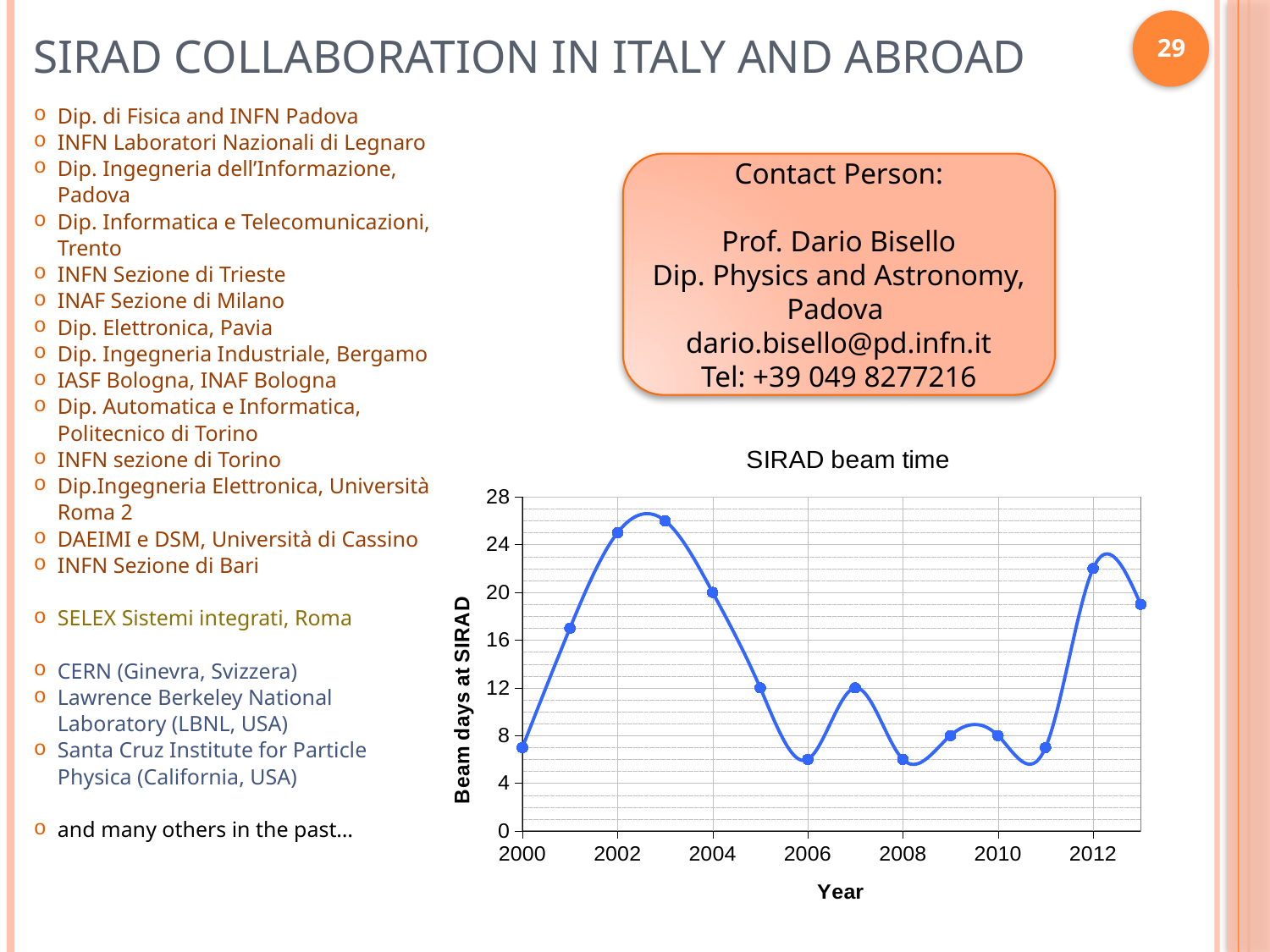
What kind of chart is the SIRAD beam time chart? line chart How many beam days at SIRAD are shown for 2004? 20 What is the label of the vertical axis of the SIRAD beam time chart? Beam days at SIRAD Which year has more beam days at SIRAD, 2002 or 2012? 2002 How many beam days at SIRAD are shown for 2010? 8 Is the value for 2002 greater or less than 24? greater Is the value for 2012 greater or less than 20? greater How many data points are plotted on the SIRAD beam time chart? 14 Is the value for 2000 greater or less than 8? less Do the beam days at SIRAD rise or fall from 2003 to 2006? fall How many beam days at SIRAD are shown for 2007? 12 What is the title of the chart on the slide? SIRAD beam time